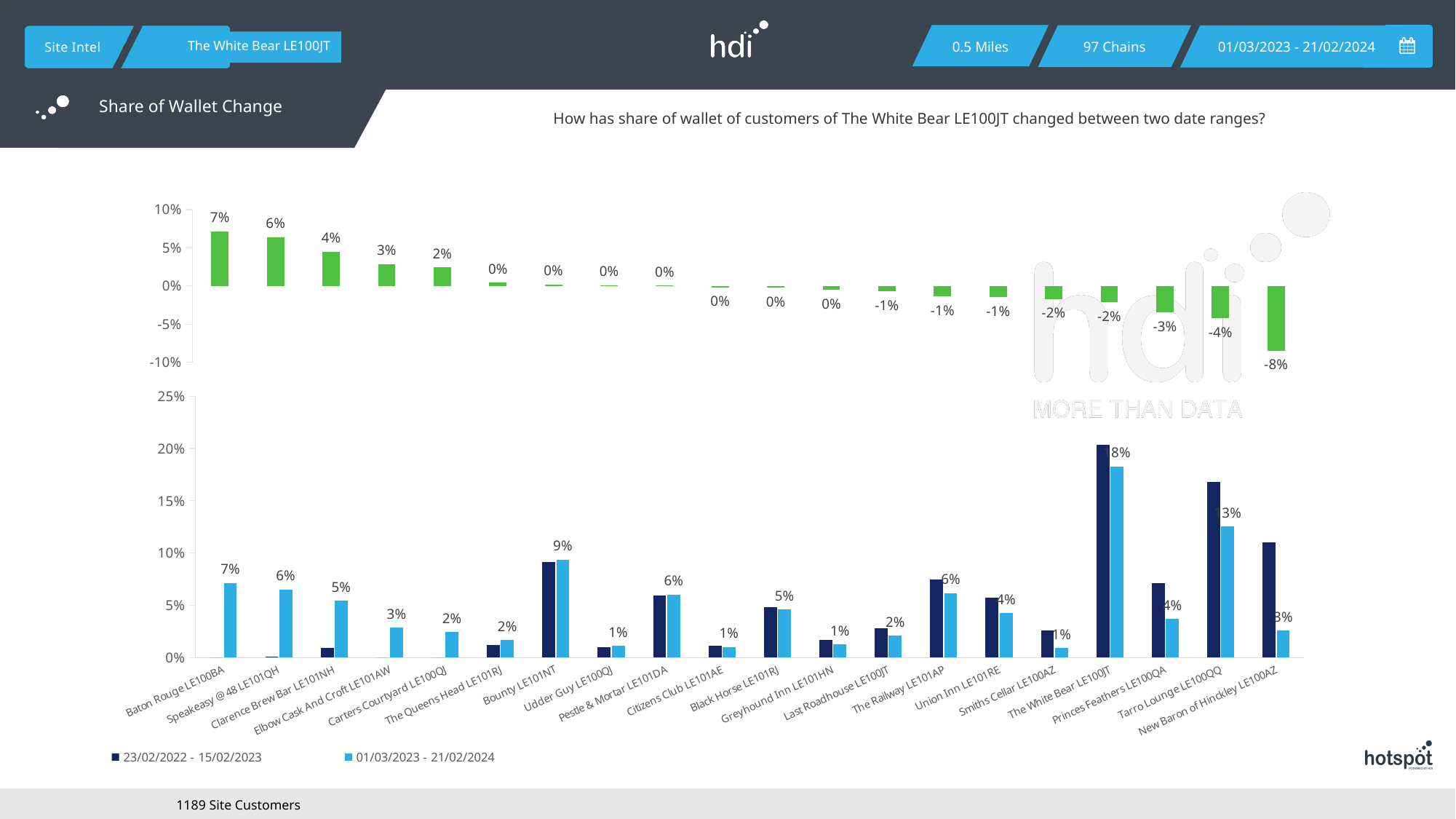
In the bottom chart, what is the value for The White Bear LE100JT in the 01/03/2023 - 21/02/2024 series? 18% In the top chart, which category has the highest share of wallet change? Baton Rouge LE100BA In the bottom chart, what is the value for Bounty LE101NT in the 01/03/2023 - 21/02/2024 series? 9% What kind of chart is the bottom chart? Bar chart How many categories are shown on the x axis of the bottom chart? 20 In the bottom chart, for Tarro Lounge LE100QQ, which series has the larger value? 23/02/2022 - 15/02/2023 In the bottom chart, what is the difference between the 01/03/2023 - 21/02/2024 values for The White Bear LE100JT and Tarro Lounge LE100QQ? 5 percentage points How many series does the legend of the bottom chart list? 2 In the top chart, which category has the lowest share of wallet change? New Baron of Hinckley LE100AZ In the top chart, what is the share of wallet change for Baton Rouge LE100BA? 7% In the top chart, what is the value for Tarro Lounge LE100QQ? -4% In the bottom chart, is the value for The White Bear LE100JT in the 23/02/2022 - 15/02/2023 series greater or less than 15%? greater